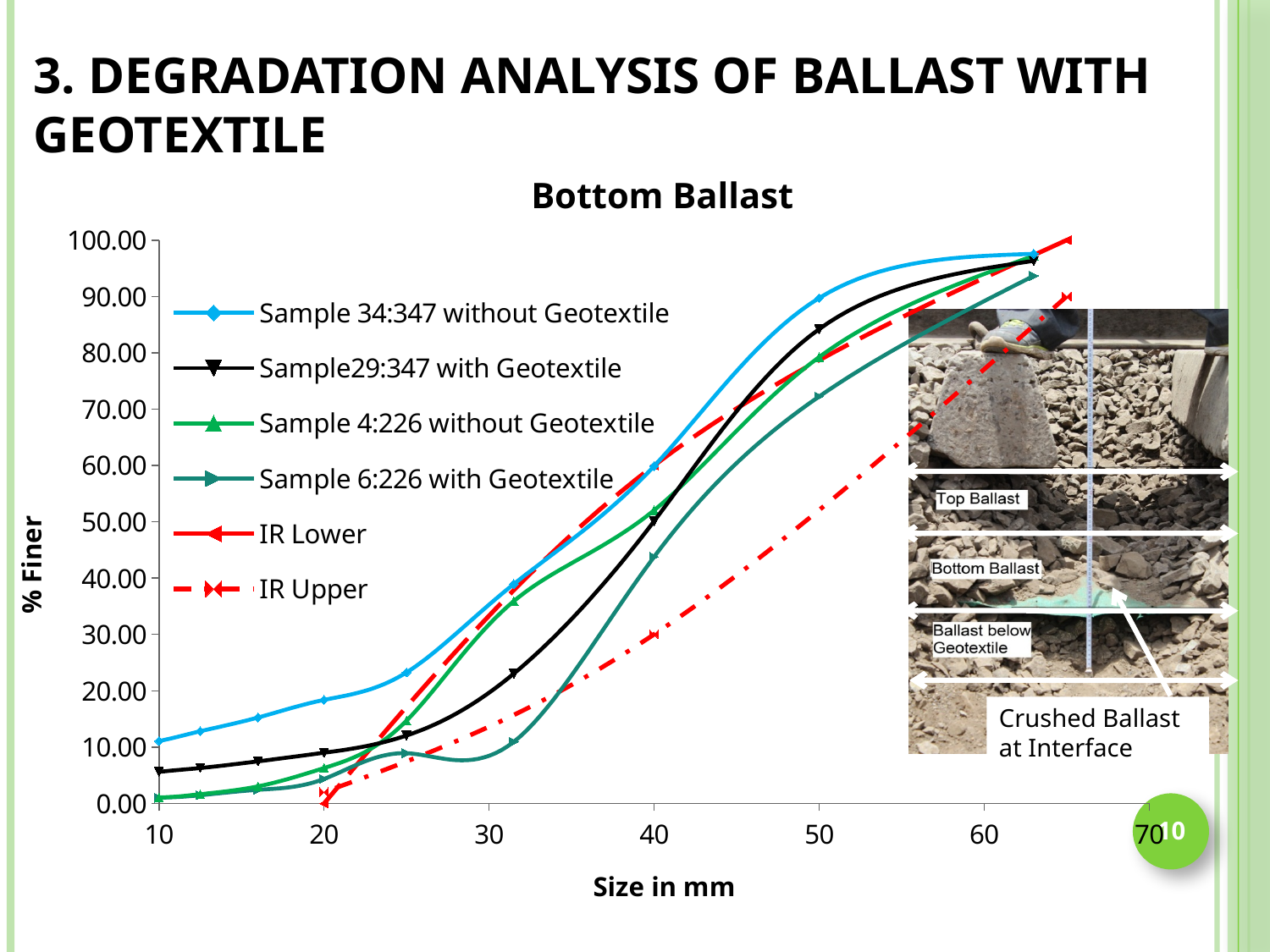
What is the title of the chart? Bottom Ballast Is the value for Sample 4:226 without Geotextile at size 31.5 mm greater or less than 30? greater Do the values of the Sample 34:347 without Geotextile series rise or fall as size increases? Rise What is the label of the x axis of the chart? Size in mm How many series does the legend of the chart list? 6 Is the value for Sample 34:347 without Geotextile at size 25 mm greater or less than 20? greater At size 40 mm, which is higher: Sample 34:347 without Geotextile or Sample 6:226 with Geotextile? Sample 34:347 without Geotextile Is the value for Sample 6:226 with Geotextile at size 40 mm greater or less than 40? greater Which series has the highest value at size 10 mm? Sample 34:347 without Geotextile What kind of chart is shown on the slide? Line chart What is the highest value shown on the y axis of the chart? 100.00